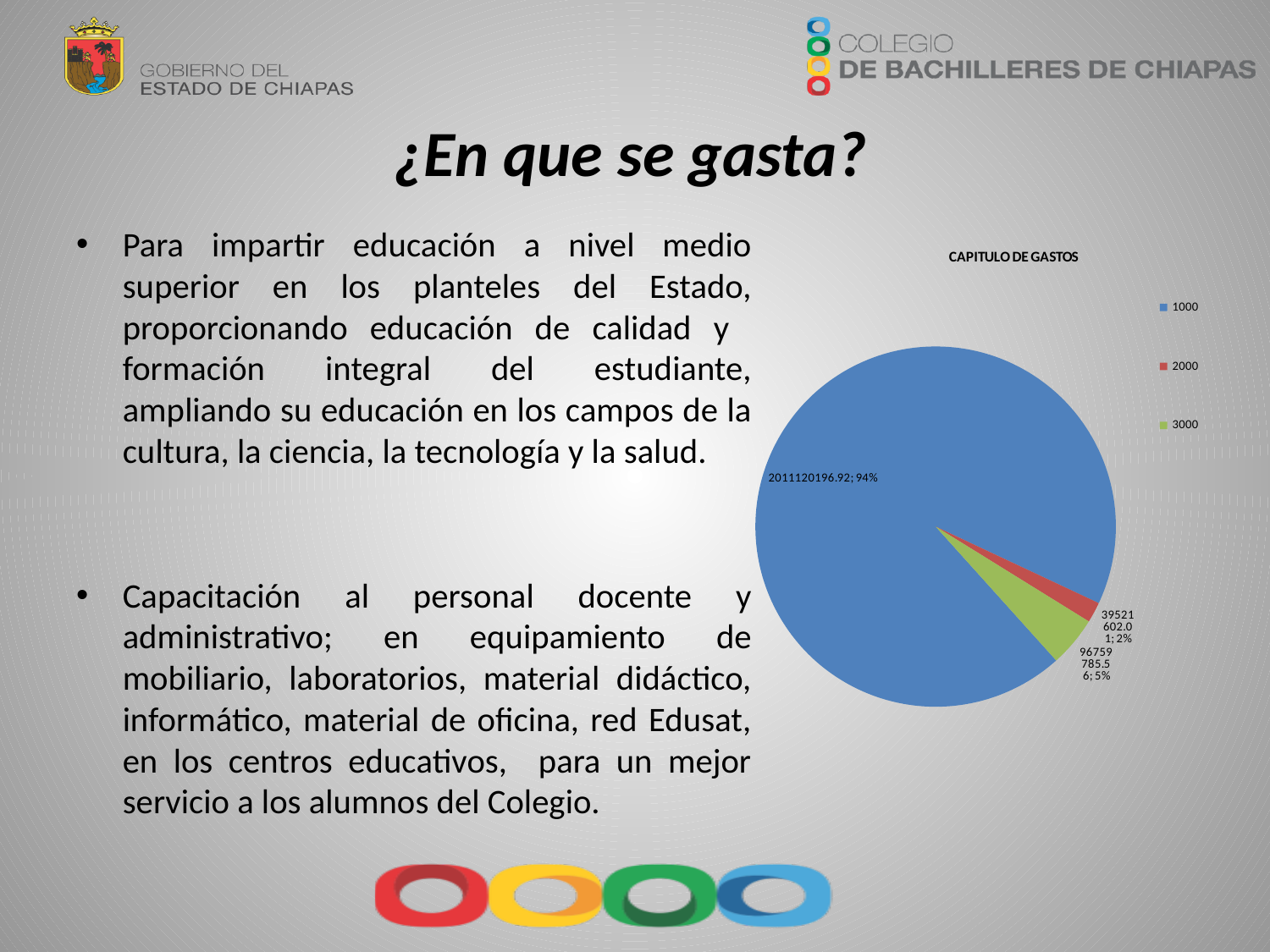
Which slice is larger, 2000 or 3000? 3000 What kind of chart is shown on the slide? pie chart Which category has the largest slice of the pie chart? 1000 What share of the pie does the 2000 category represent? 2% How many entries does the legend of the pie chart list? 3 What is the title of the chart on the slide? CAPITULO DE GASTOS What colour is the slice for the 1000 category? blue How many slices does the pie chart have? 3 What share of the pie does the 3000 category represent? 5% What share of the pie does the 1000 category represent? 94% Which category has the smallest slice of the pie chart? 2000 What is the value shown for the 1000 category in the pie chart? 2011120196.92